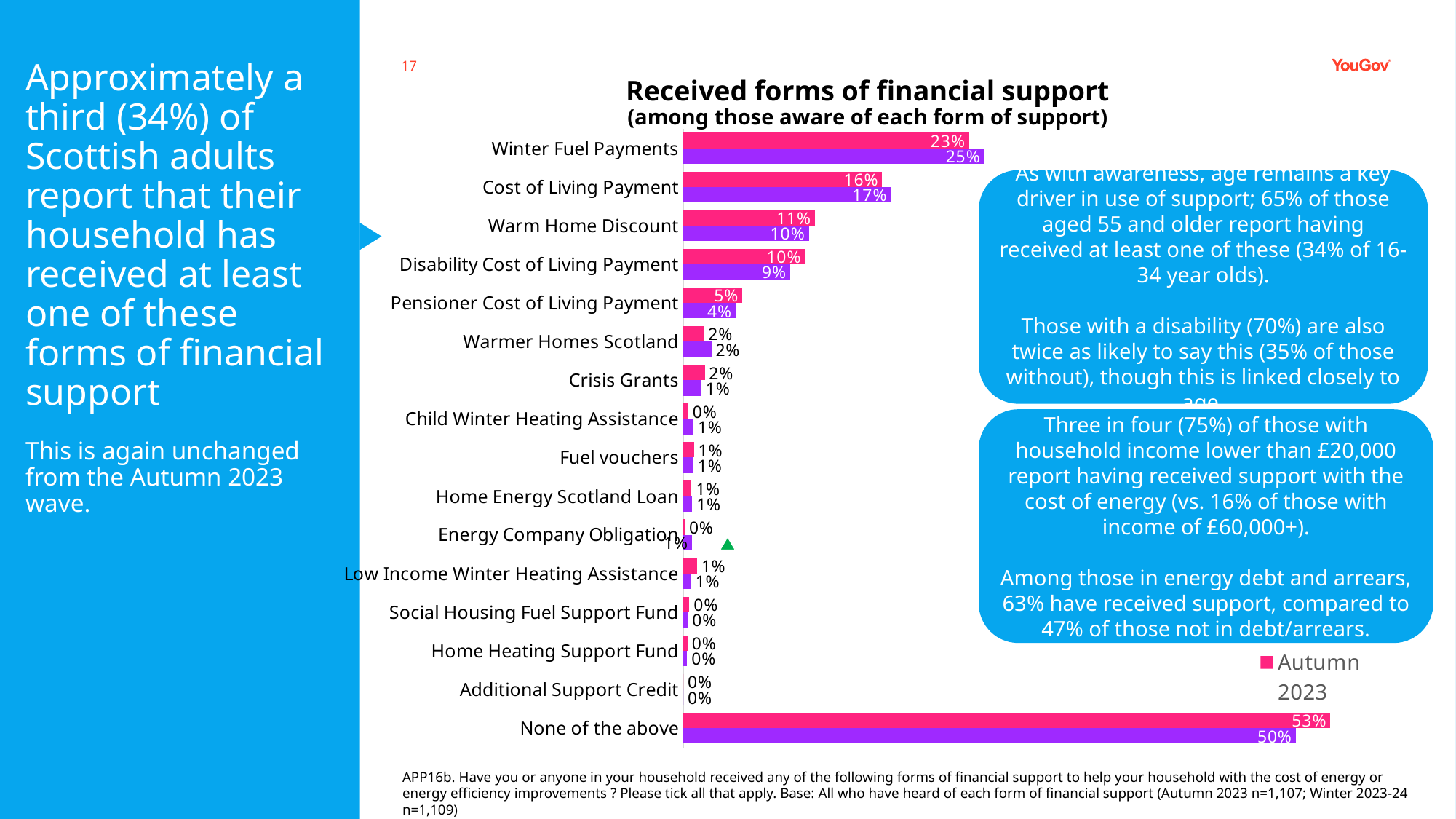
What is the difference between the two bars for None of the above? 3% What is the Autumn 2023 value for None of the above? 53% How many categories are listed on the chart? 16 What is the title of the chart? Received forms of financial support What is the Autumn 2023 value for Warm Home Discount? 11% Which is larger for Disability Cost of Living Payment: the Autumn 2023 value or the purple-bar value? Autumn 2023 What is the purple-bar value for Cost of Living Payment? 17% Which category has the highest Autumn 2023 value? None of the above What is the Autumn 2023 value for Winter Fuel Payments? 23% What is the difference between the Autumn 2023 values for Winter Fuel Payments and Cost of Living Payment? 7% What type of chart is shown on the slide? Bar chart Excluding None of the above, which form of support has the highest Autumn 2023 value? Winter Fuel Payments